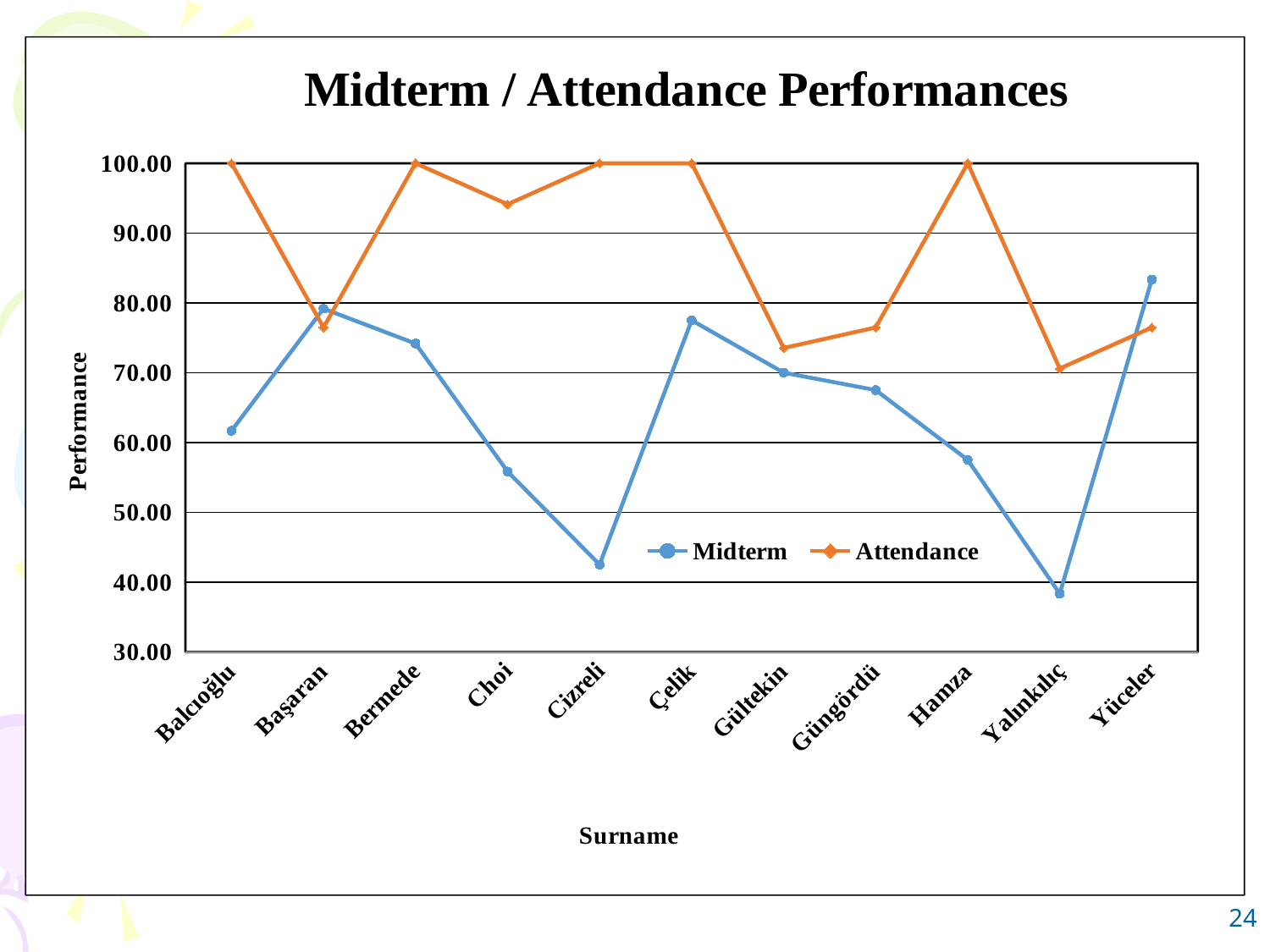
Does the Midterm line rise or fall from Bermede to Cizreli? fall How many surnames are plotted along the x axis? 11 Which surname has the lowest Attendance value? Yalınkılıç What kind of chart is shown on the slide? line chart Which surname has the lowest Midterm value? Yalınkılıç Is the Midterm value for Choi greater or less than 60.00? less Which surname has the highest Midterm value? Yüceler How many series does the legend list? 2 What is the Attendance value for Bermede? 100.00 Which is larger, the Midterm value for Çelik or the Midterm value for Gültekin? Çelik What is the Attendance value for Hamza? 100.00 Is the Attendance value for Choi greater or less than 90.00? greater